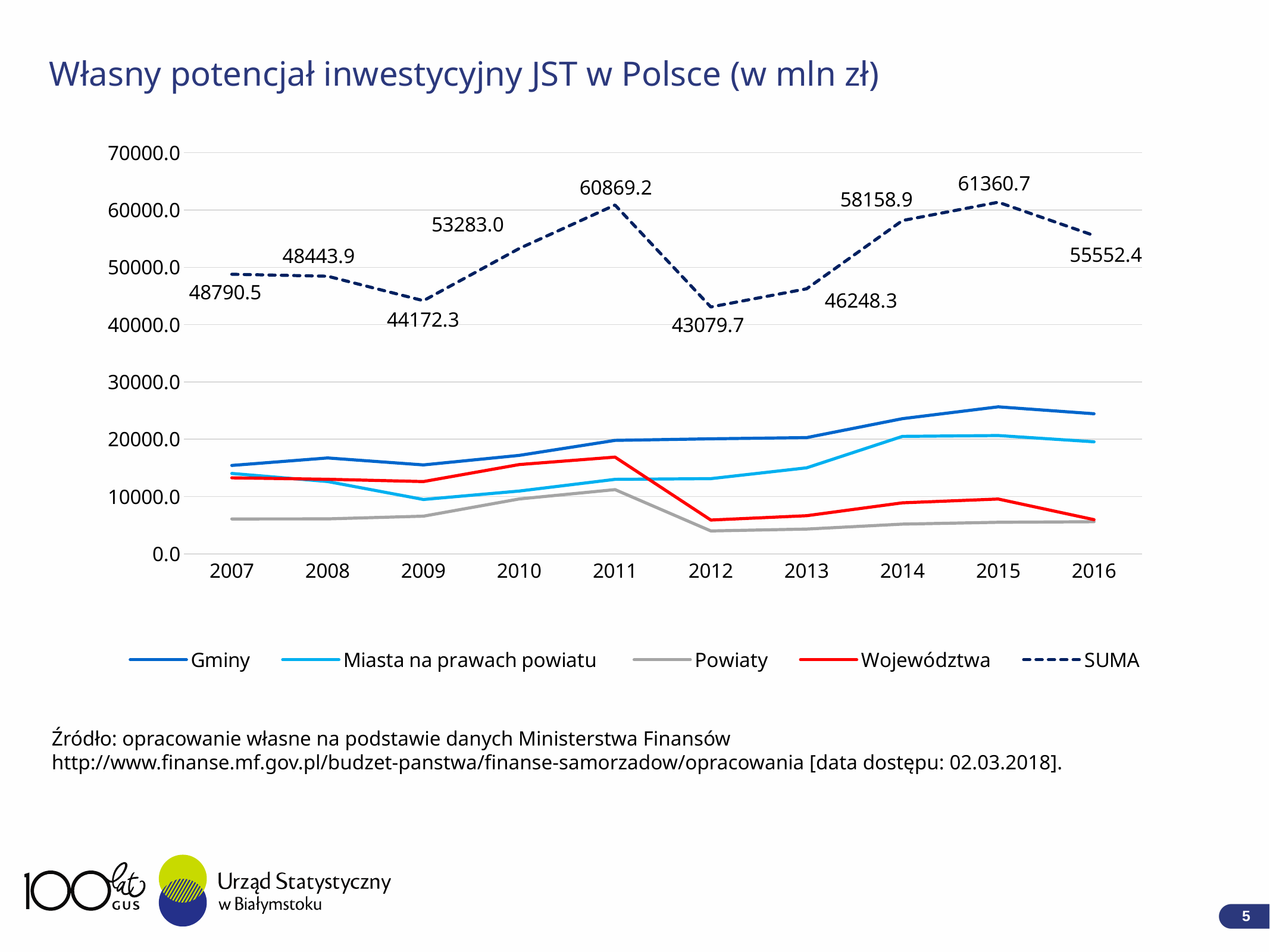
What is the SUMA value for 2012? 43079.7 In which year is the SUMA series highest? 2015 In which year is the SUMA series lowest? 2012 How many series does the legend list? 5 How many years are shown on the x axis? 10 What is the SUMA value for 2007? 48790.5 Which is larger in 2014: Miasta na prawach powiatu or Województwa? Miasta na prawach powiatu What is the difference between the SUMA values for 2015 and 2012? 18281.0 What kind of chart is shown on the slide? line chart Is the value for Gminy in 2015 greater or less than 20000.0? greater What is the SUMA value for 2015? 61360.7 Is the value for Powiaty in 2012 greater or less than 10000.0? less